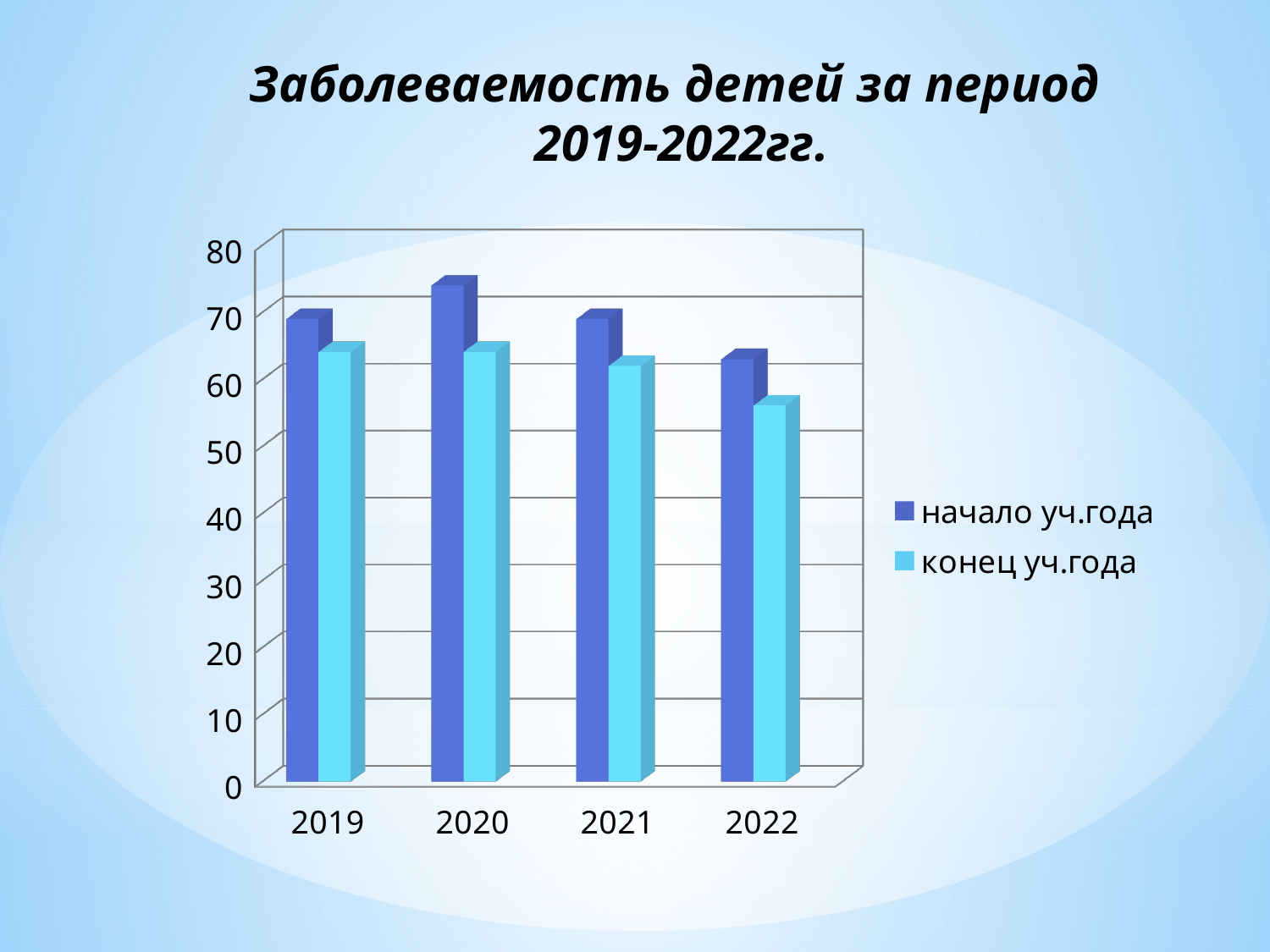
In which year is the value for 'конец уч.года' the lowest? 2022 How many series does the legend list? 2 In 2022, which series has the larger value: 'начало уч.года' or 'конец уч.года'? начало уч.года Which is larger: 'начало уч.года' in 2020 or 'начало уч.года' in 2022? 2020 Is the value for 'начало уч.года' in 2020 greater or less than 70? greater What is the title of the chart? Заболеваемость детей за период 2019-2022гг. What kind of chart is shown on the slide? bar chart In which year is the value for 'начало уч.года' the highest? 2020 Which series is shown in light blue according to the legend? конец уч.года From 2019 to 2022, do the values for 'конец уч.года' rise or fall overall? fall Is the value for 'конец уч.года' in 2022 greater or less than 60? less How many years are shown on the x axis of the chart? 4